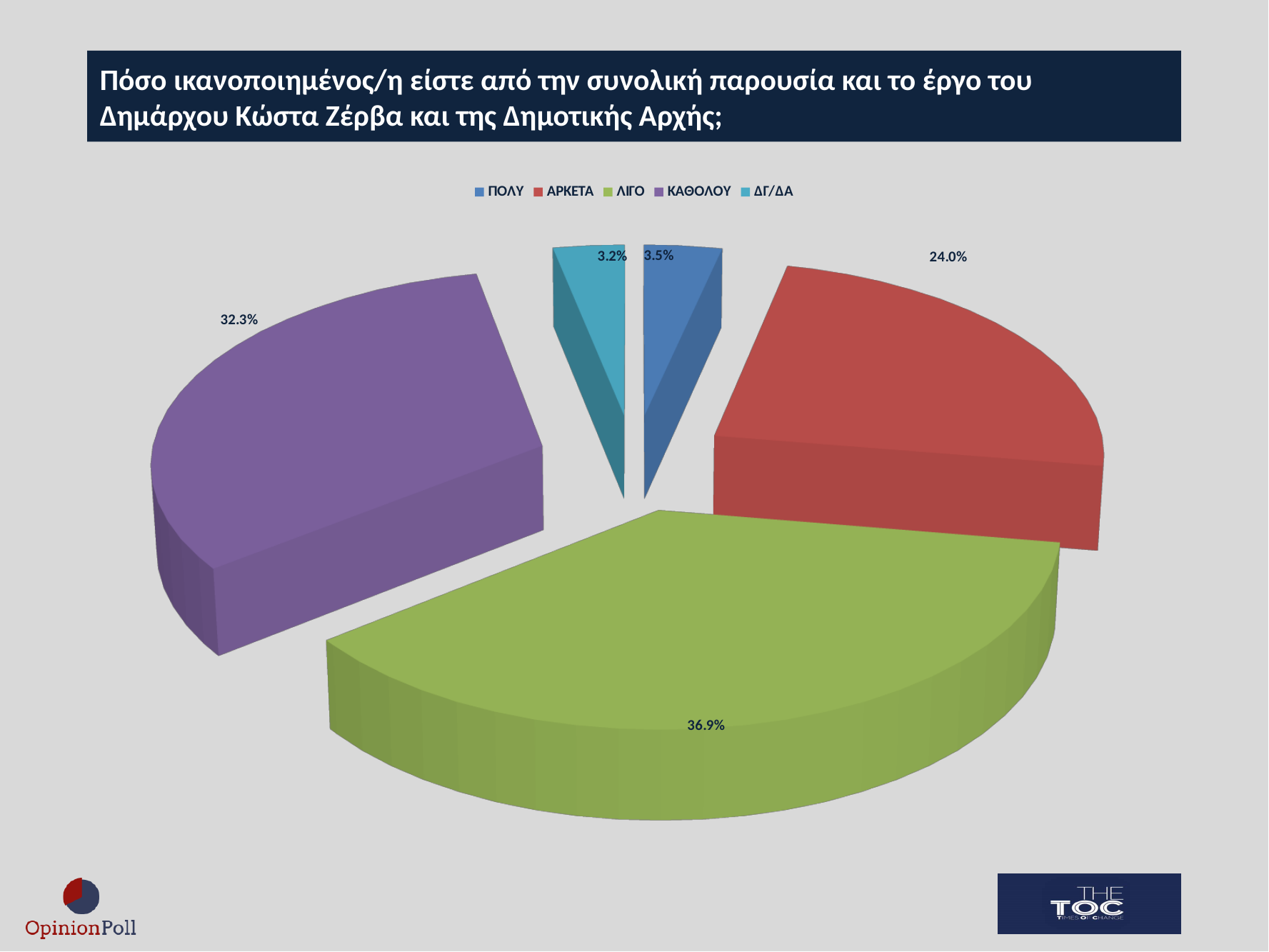
What percentage of respondents answered ΠΟΛΥ? 3.5% Which response category has the smallest share of the pie? ΔΓ/ΔΑ What percentage of respondents answered ΚΑΘΟΛΟΥ? 32.3% What percentage of respondents answered ΛΙΓΟ? 36.9% Which is larger, the share for ΑΡΚΕΤΑ or the share for ΚΑΘΟΛΟΥ? ΚΑΘΟΛΟΥ What type of chart is shown on the slide? Pie chart What percentage of respondents answered ΑΡΚΕΤΑ? 24.0% What colour represents ΚΑΘΟΛΟΥ in the chart? Purple What is the difference in percentage points between ΛΙΓΟ and ΚΑΘΟΛΟΥ? 4.6 How many categories does the pie chart show? 5 Which response category has the largest share of the pie? ΛΙΓΟ What percentage of respondents answered ΔΓ/ΔΑ? 3.2%